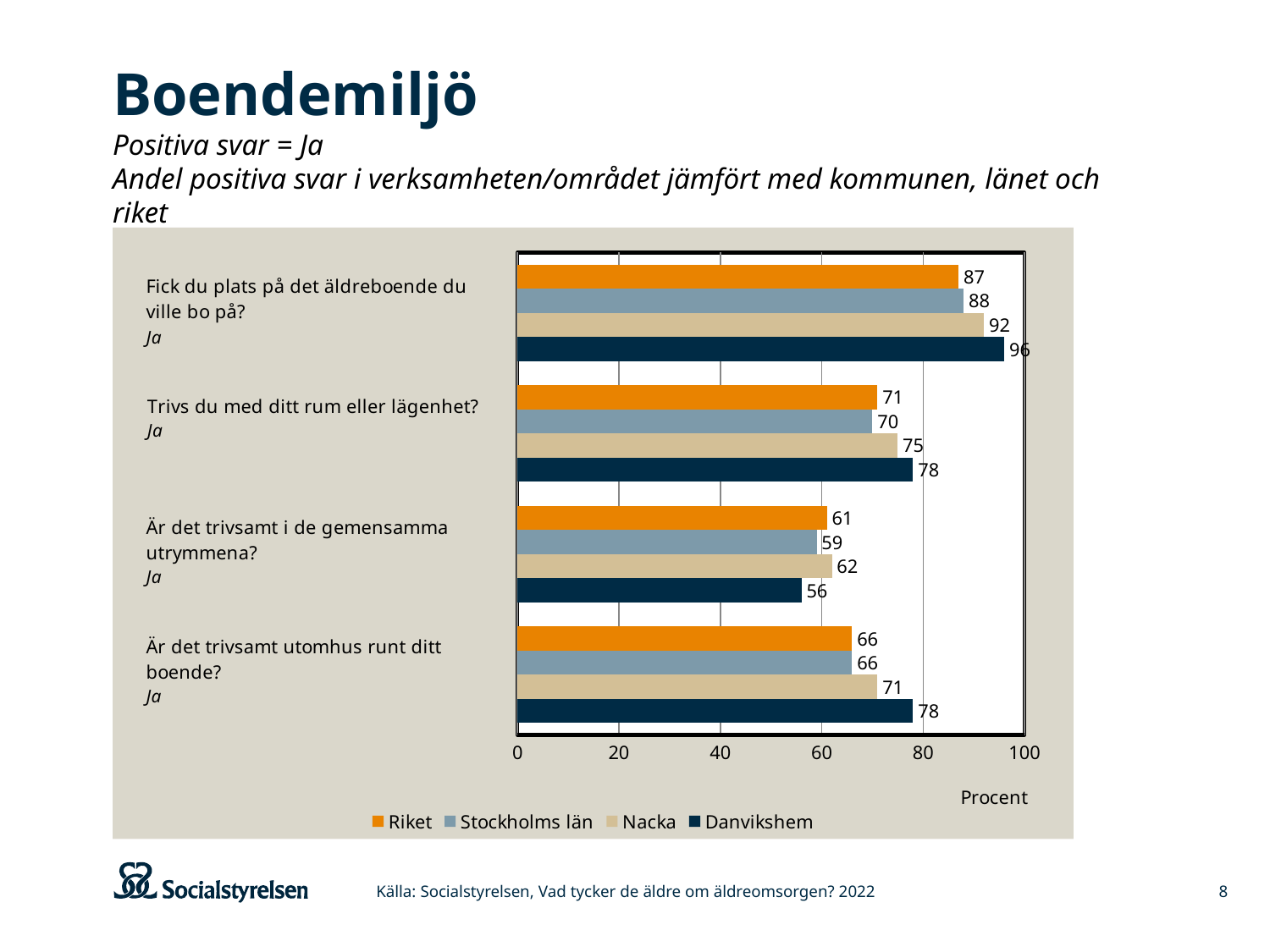
How many series does the legend list? 4 What is the value for Danvikshem for "Fick du plats på det äldreboende du ville bo på?"? 96 What is the difference between the Danvikshem and Riket values for "Är det trivsamt utomhus runt ditt boende?"? 12 What is the label on the horizontal axis of the chart? Procent Which series has the lowest value for "Är det trivsamt i de gemensamma utrymmena?"? Danvikshem Which series has the highest value for "Trivs du med ditt rum eller lägenhet?"? Danvikshem How many question categories are shown on the chart? 4 For "Fick du plats på det äldreboende du ville bo på?", which is larger: the value for Nacka or the value for Stockholms län? Nacka What is the value for Nacka for "Är det trivsamt i de gemensamma utrymmena?"? 62 What is the value for Riket for "Trivs du med ditt rum eller lägenhet?"? 71 What is the value for Stockholms län for "Är det trivsamt utomhus runt ditt boende?"? 66 What kind of chart is shown on the slide? bar chart